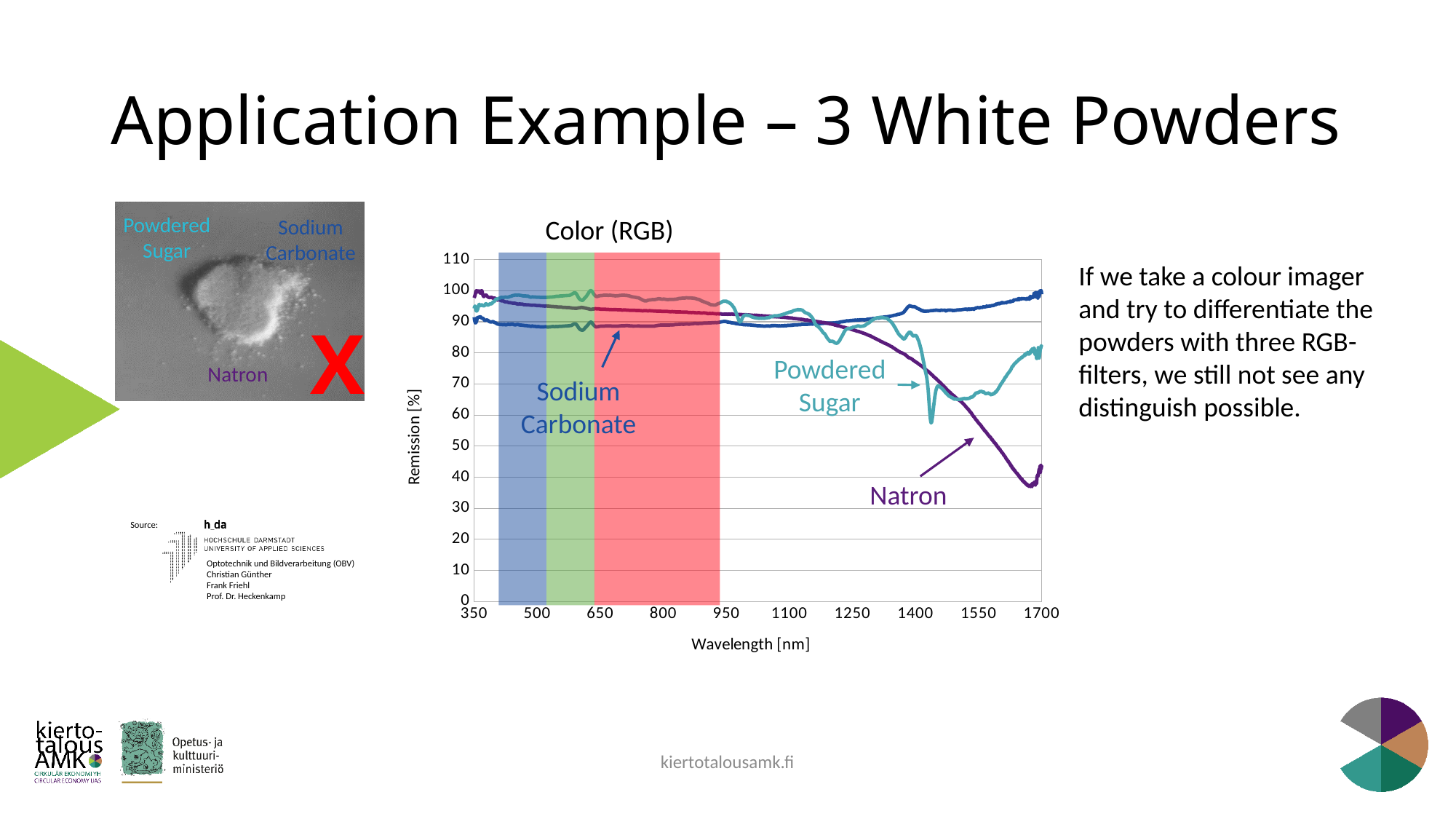
At 1700 nm, which series has the highest Remission value? Sodium Carbonate Is the Remission value for Powdered Sugar at 1700 nm greater or less than 70? greater At 1700 nm, which has a higher Remission value, Powdered Sugar or Natron? Powdered Sugar How many powders (series) are plotted in the chart? 3 Is the Remission value for Natron at 1650 nm greater or less than 50? less Is the Remission value for Sodium Carbonate at 1700 nm greater or less than 90? greater What kind of chart is shown on the slide? Line chart At 1700 nm, which series has the lowest Remission value? Natron What is the label of the y axis of the chart? Remission [%] What is the label of the x axis of the chart? Wavelength [nm] Does the Remission value for Natron rise or fall as the wavelength increases from 950 nm to 1650 nm? fall